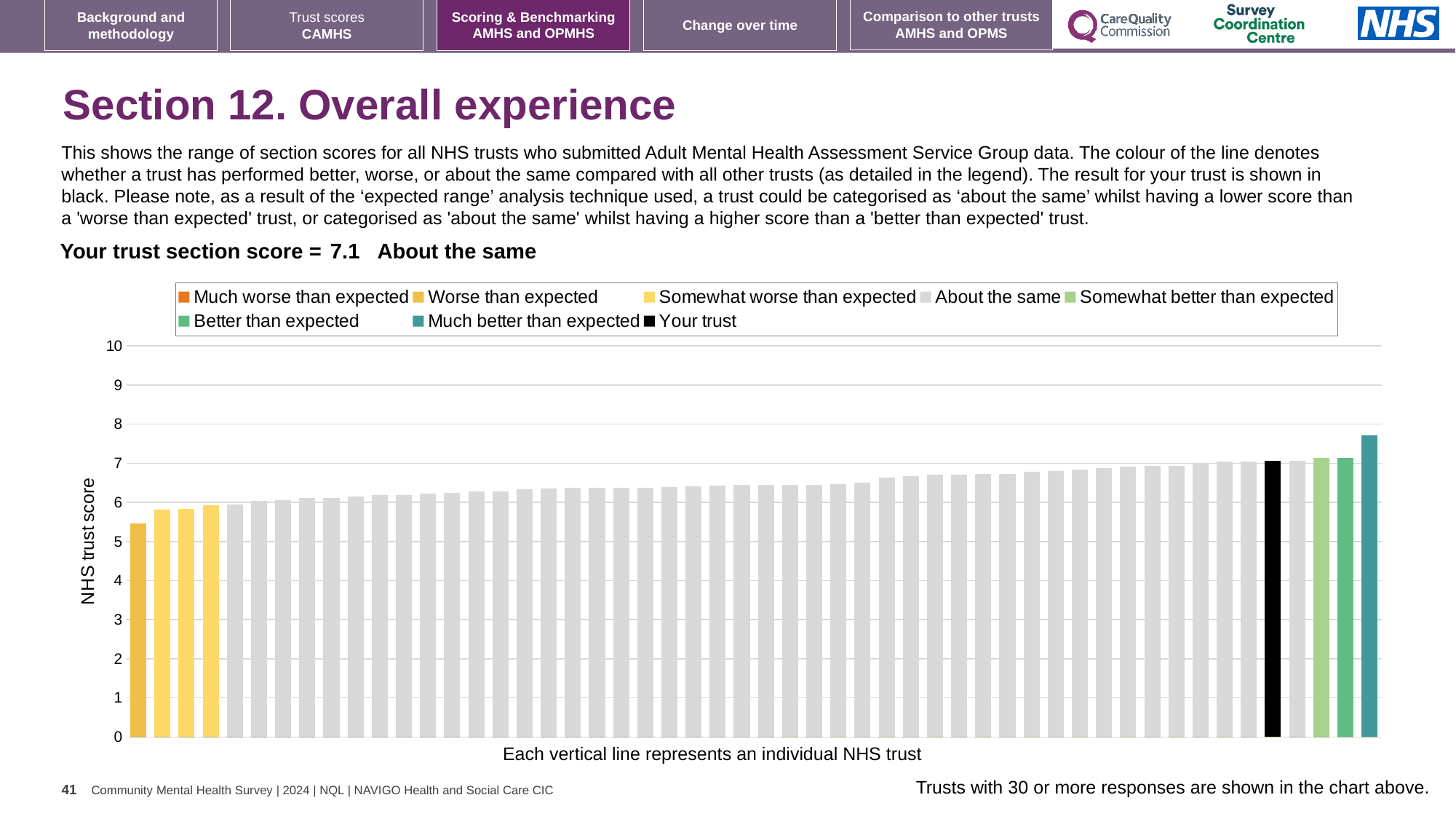
Is the value of the highest bar in the chart greater or less than 7? greater Is the value of the lowest bar in the chart greater or less than 6? less Which legend category does the highest bar in the chart belong to? Much better than expected Do the bar values rise or fall from left to right across the chart? rise What kind of chart is shown on the slide? bar chart Which legend category does the lowest bar in the chart belong to? Worse than expected How is your trust categorised compared with other trusts? About the same Is the value for your trust (the black bar) greater or less than 6? greater What is the label on the vertical axis of the chart? NHS trust score What colour is the bar representing your trust? black How many entries does the chart legend list? 8 What is the section score for your trust shown on the slide? 7.1